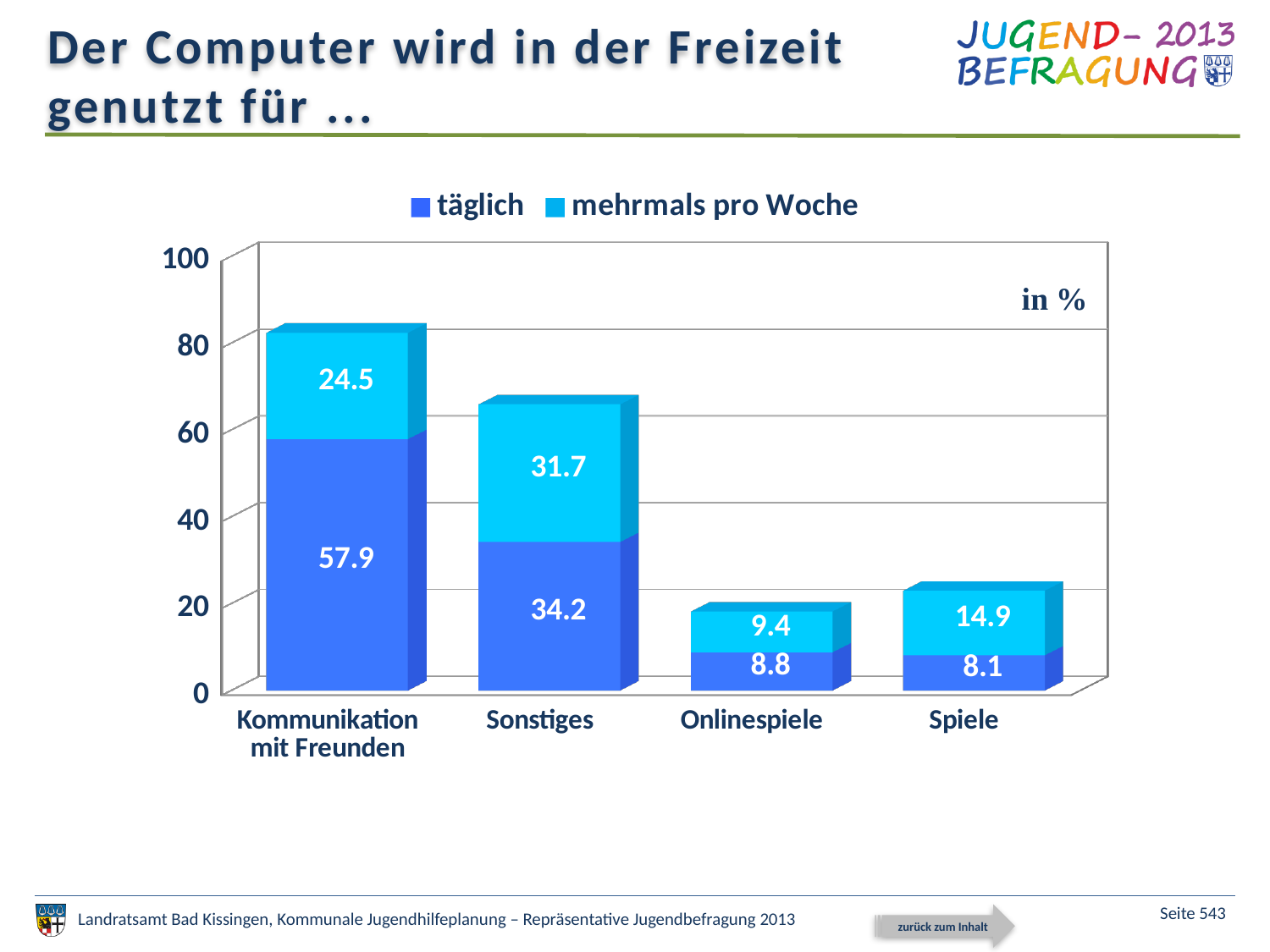
Which is larger for Spiele: the 'täglich' value or the 'mehrmals pro Woche' value? mehrmals pro Woche What kind of chart is shown on the slide? Stacked bar chart Which category has the highest 'täglich' value? Kommunikation mit Freunden How many categories are shown on the x axis? 4 What is the 'täglich' value for Kommunikation mit Freunden? 57.9 Which category has the lowest 'mehrmals pro Woche' value? Onlinespiele How many series does the legend list? 2 What is the 'mehrmals pro Woche' value for Sonstiges? 31.7 What is the difference between the 'täglich' values for Kommunikation mit Freunden and Sonstiges? 23.7 What is the total of the stacked bar for Sonstiges? 65.9 What is the 'täglich' value for Spiele? 8.1 What is the total of the stacked bar for Onlinespiele? 18.2